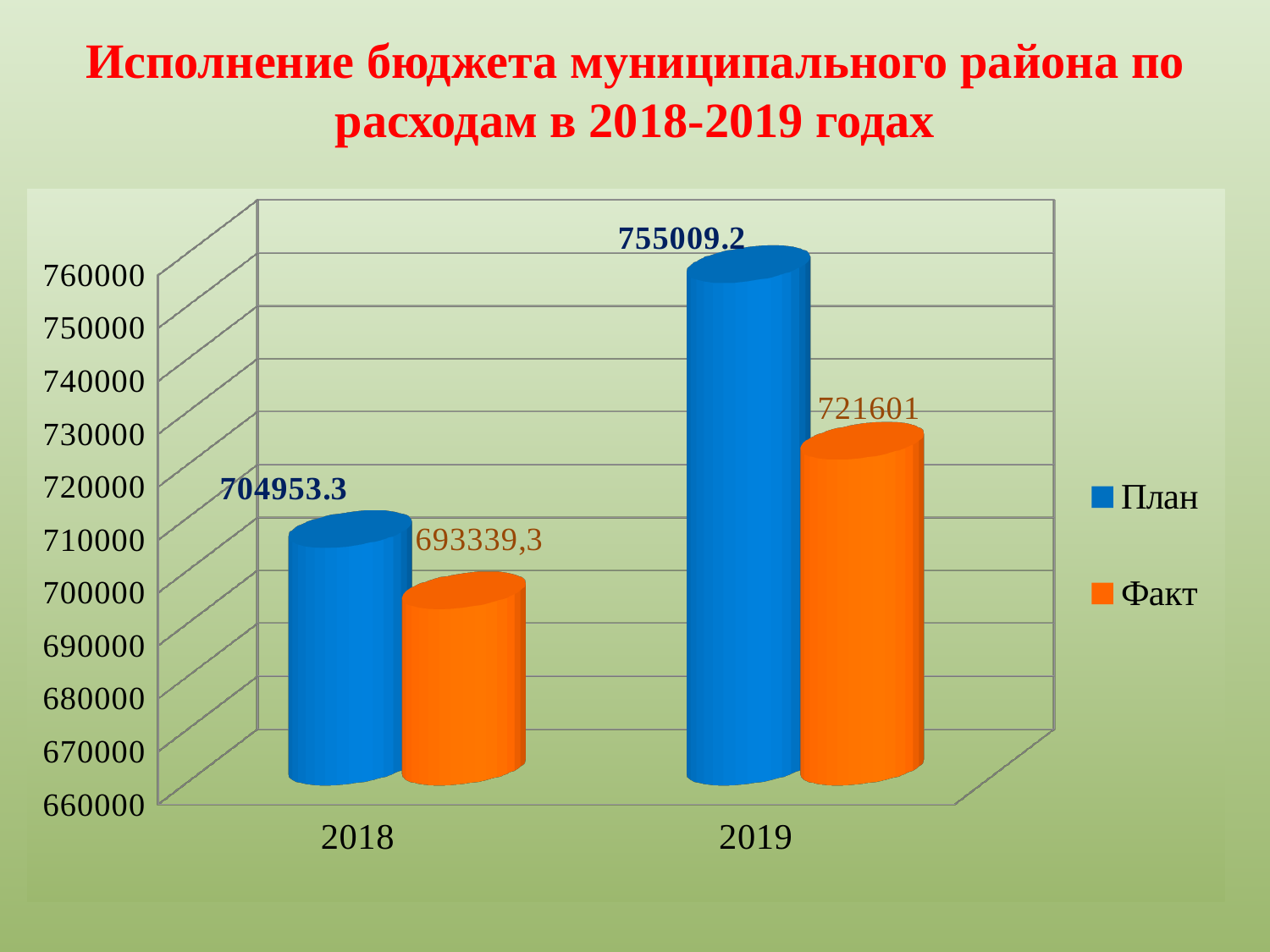
What is the План value for 2018? 704953.3 What is the difference between the План and Факт values for 2019? 33408.2 What is the Факт value for 2019? 721601 What kind of chart is shown on the slide? Bar chart How many series does the legend list? 2 What is the difference between the План values for 2019 and 2018? 50055.9 Do the Факт values rise or fall from 2018 to 2019? Rise What is the План value for 2019? 755009.2 What is the Факт value for 2018? 693339,3 Which is larger for 2018, the План value or the Факт value? План Which year has the highest План value? 2019 Which year has the lowest Факт value? 2018